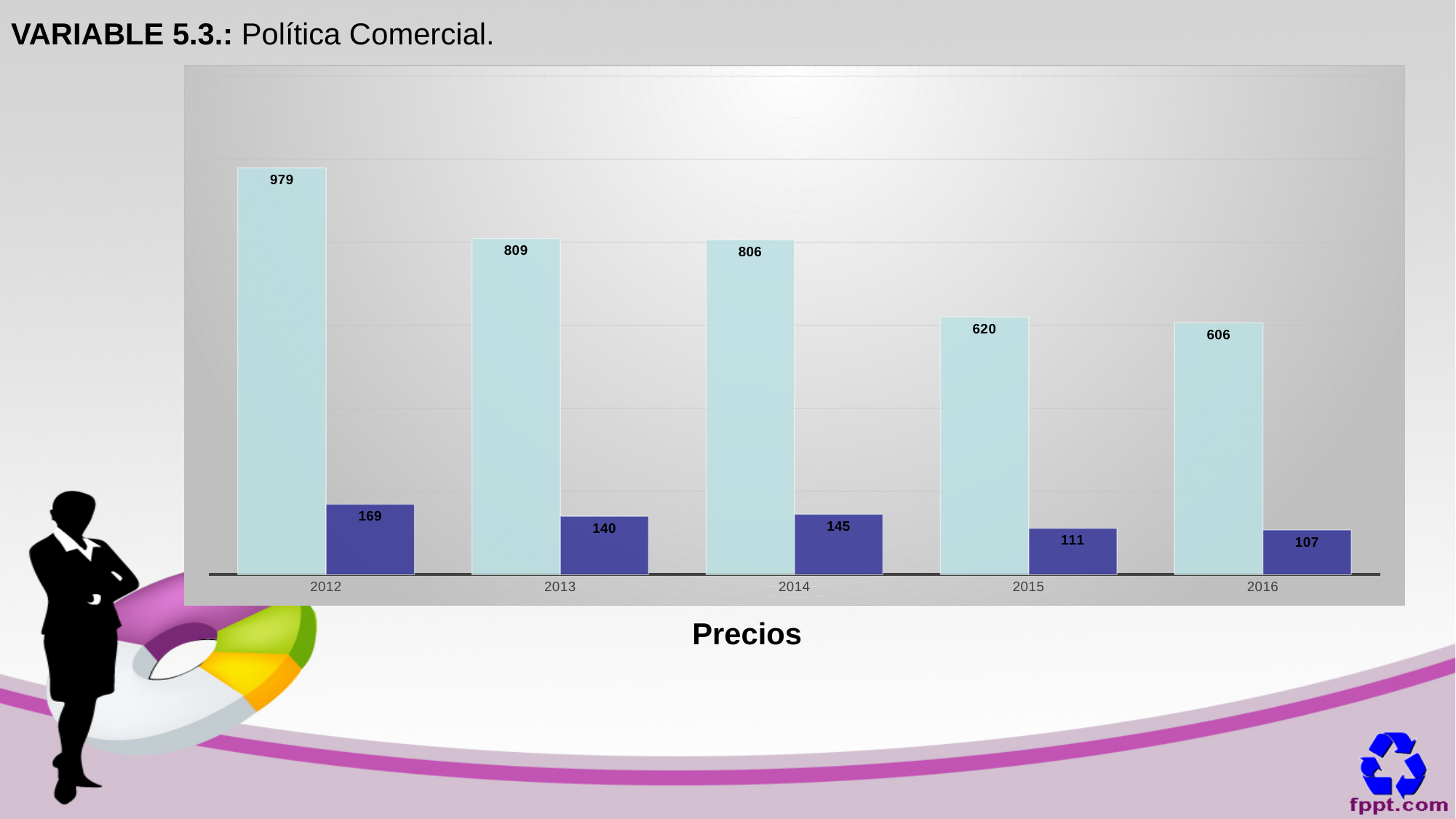
Do the light blue bar values rise or fall from 2012 to 2016? Fall Which year has the lowest dark purple bar? 2016 What kind of chart is shown on the slide? Bar chart What is the title shown below the chart? Precios What is the difference between the light blue and dark purple bars in 2015? 509 What is the value of the dark purple bar for 2016? 107 What is the difference between the light blue bar values for 2012 and 2013? 170 What is the value of the light blue bar for 2012? 979 Which is larger, the dark purple bar for 2013 or for 2014? 2014 What is the value of the dark purple bar for 2014? 145 Which year has the highest light blue bar? 2012 How many years are shown on the x axis? 5